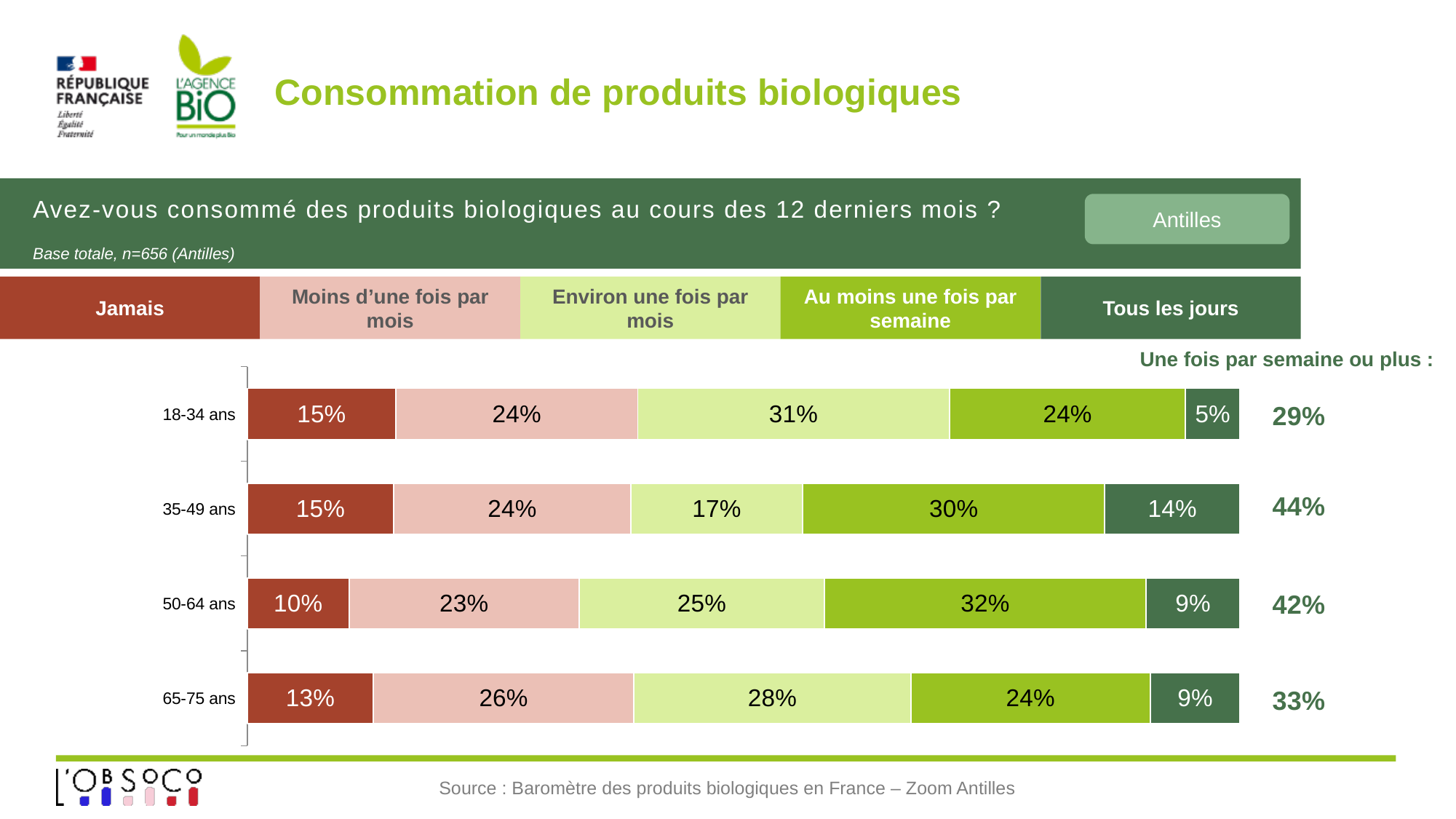
How many response categories (series) does the legend list? 5 What is the "Jamais" value for the 50-64 ans group? 10% Which age group has the highest value for "Au moins une fois par semaine"? 50-64 ans Which age group has the lowest value for "Tous les jours"? 18-34 ans What type of chart is shown on the slide? Stacked bar chart How many percentage points higher is the "Tous les jours" value for 35-49 ans than for 18-34 ans? 9 percentage points Which age group has the highest "Une fois par semaine ou plus" figure? 35-49 ans What percentage of the 35-49 ans group answered "Tous les jours"? 14% How many age groups are shown in the chart? 4 What share of the 18-34 ans group answered "Environ une fois par mois"? 31% What is the "Une fois par semaine ou plus" figure for the 50-64 ans group? 42% Which group has the larger "Moins d'une fois par mois" value, 65-75 ans or 50-64 ans? 65-75 ans